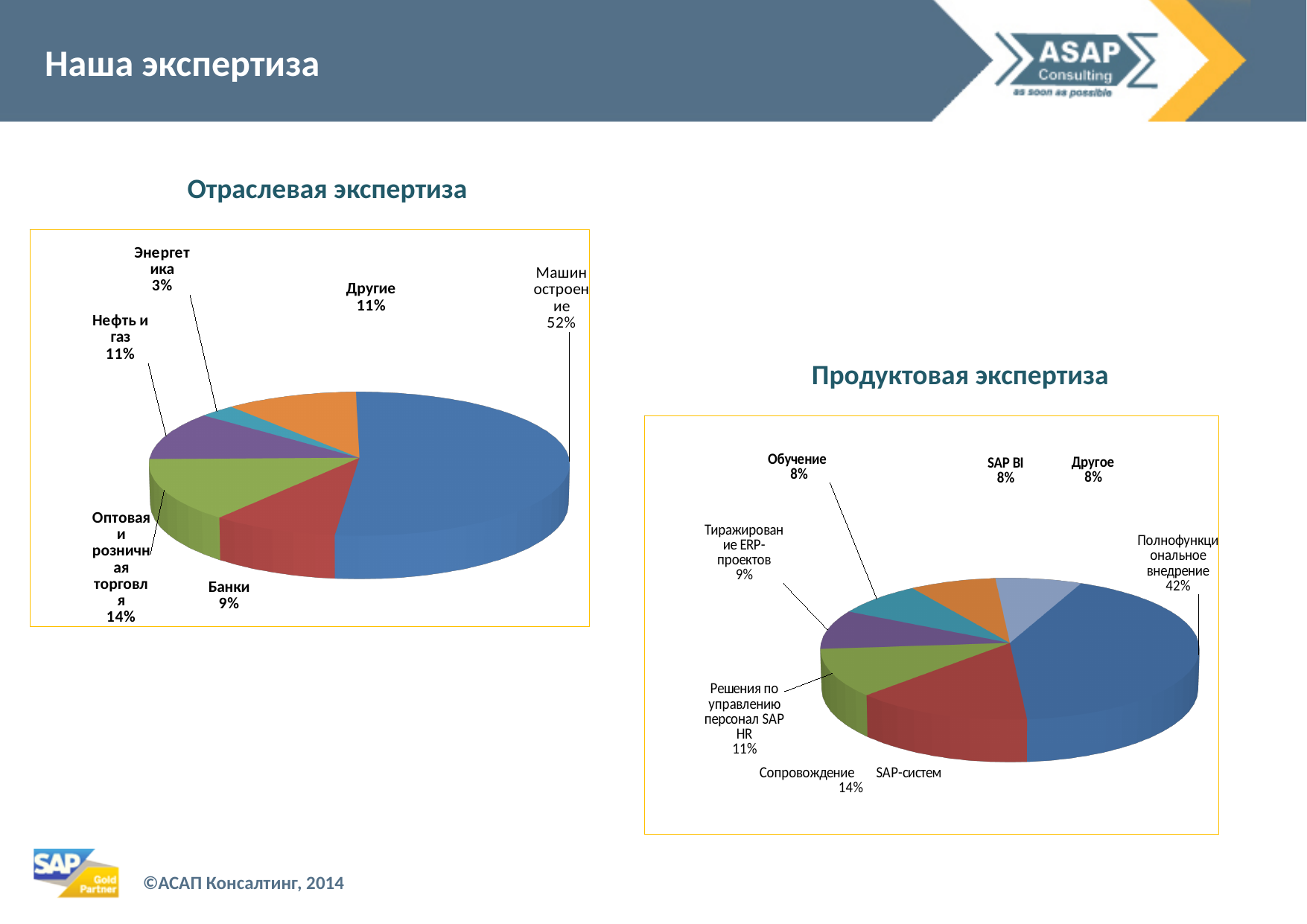
In the 'Отраслевая экспертиза' chart, what is the difference between the shares of Оптовая и розничная торговля and Банки? 5% In the 'Продуктовая экспертиза' chart, what share does Полнофункциональное внедрение have? 42% In the 'Отраслевая экспертиза' chart, which category has the largest share? Машиностроение How many slices does the 'Продуктовая экспертиза' pie chart have? 7 In the 'Продуктовая экспертиза' chart, what is the difference between the shares of Полнофункциональное внедрение and Обучение? 34% In the 'Отраслевая экспертиза' chart, what share does Оптовая и розничная торговля have? 14% In the 'Продуктовая экспертиза' chart, what share does Сопровождение SAP-систем have? 14% How many slices does the 'Отраслевая экспертиза' pie chart have? 6 In the 'Отраслевая экспертиза' chart, which category has the smallest share? Энергетика In the 'Продуктовая экспертиза' chart, which is larger: Тиражирование ERP-проектов or Решения по управлению персонал SAP HR? Решения по управлению персонал SAP HR In the 'Отраслевая экспертиза' chart, what share does Машиностроение have? 52% What type of chart is used for 'Продуктовая экспертиза'? Pie chart